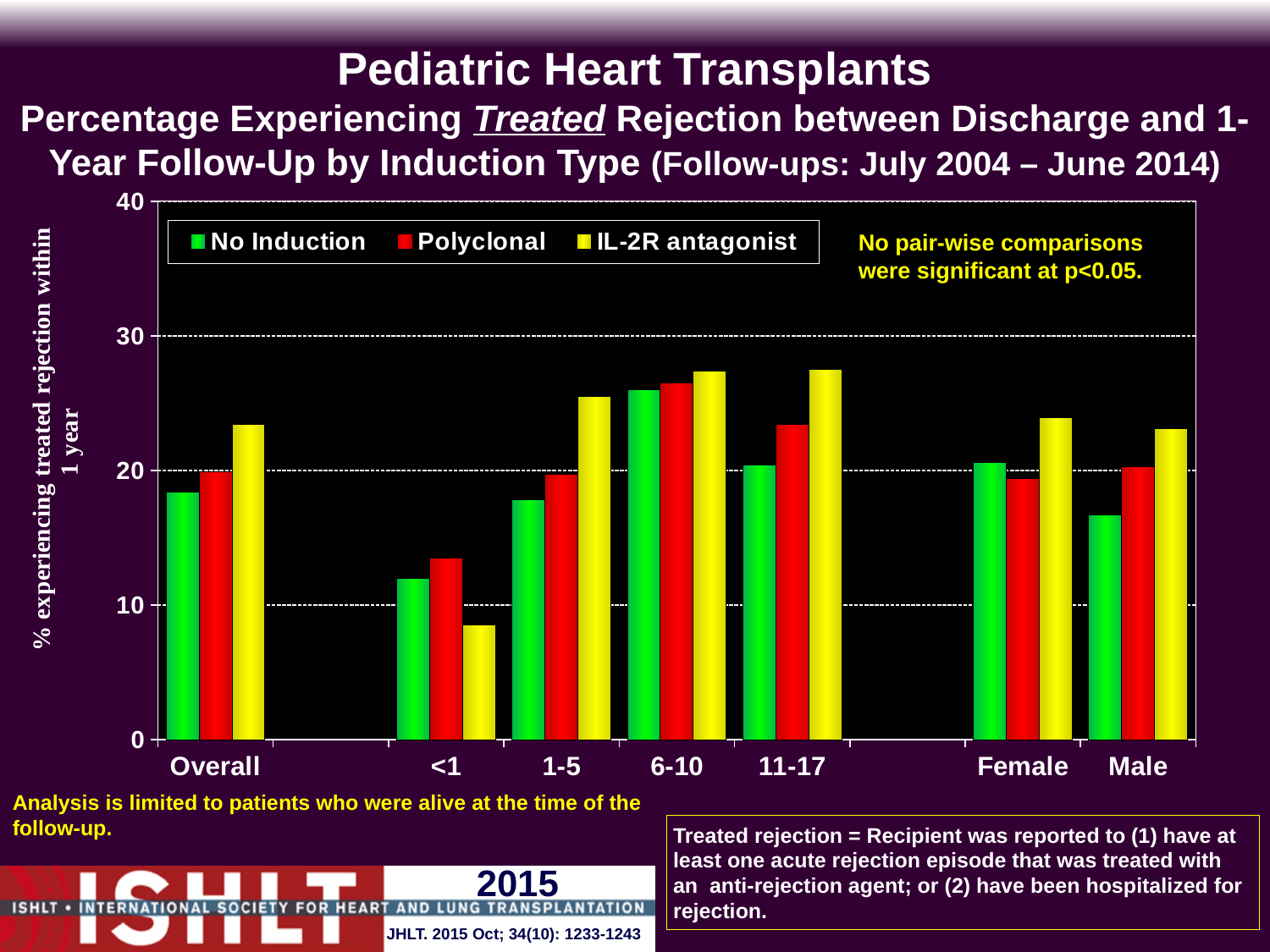
How many series does the legend list? 3 Is the value for No Induction in the Male category greater or less than 20? less Which series has the highest value in the 1-5 age group? IL-2R antagonist Which category has the lowest value for IL-2R antagonist? <1 What kind of chart is shown on the slide? bar chart Is the value for Polyclonal in the 11-17 age group greater or less than 20? greater In the <1 age group, which is larger: No Induction or IL-2R antagonist? No Induction In the Overall category, which is larger: Polyclonal or IL-2R antagonist? IL-2R antagonist In the Male category, which is larger: No Induction or Polyclonal? Polyclonal How many categories are shown along the x axis? 7 Is the value for No Induction in the 6-10 age group greater or less than 20? greater